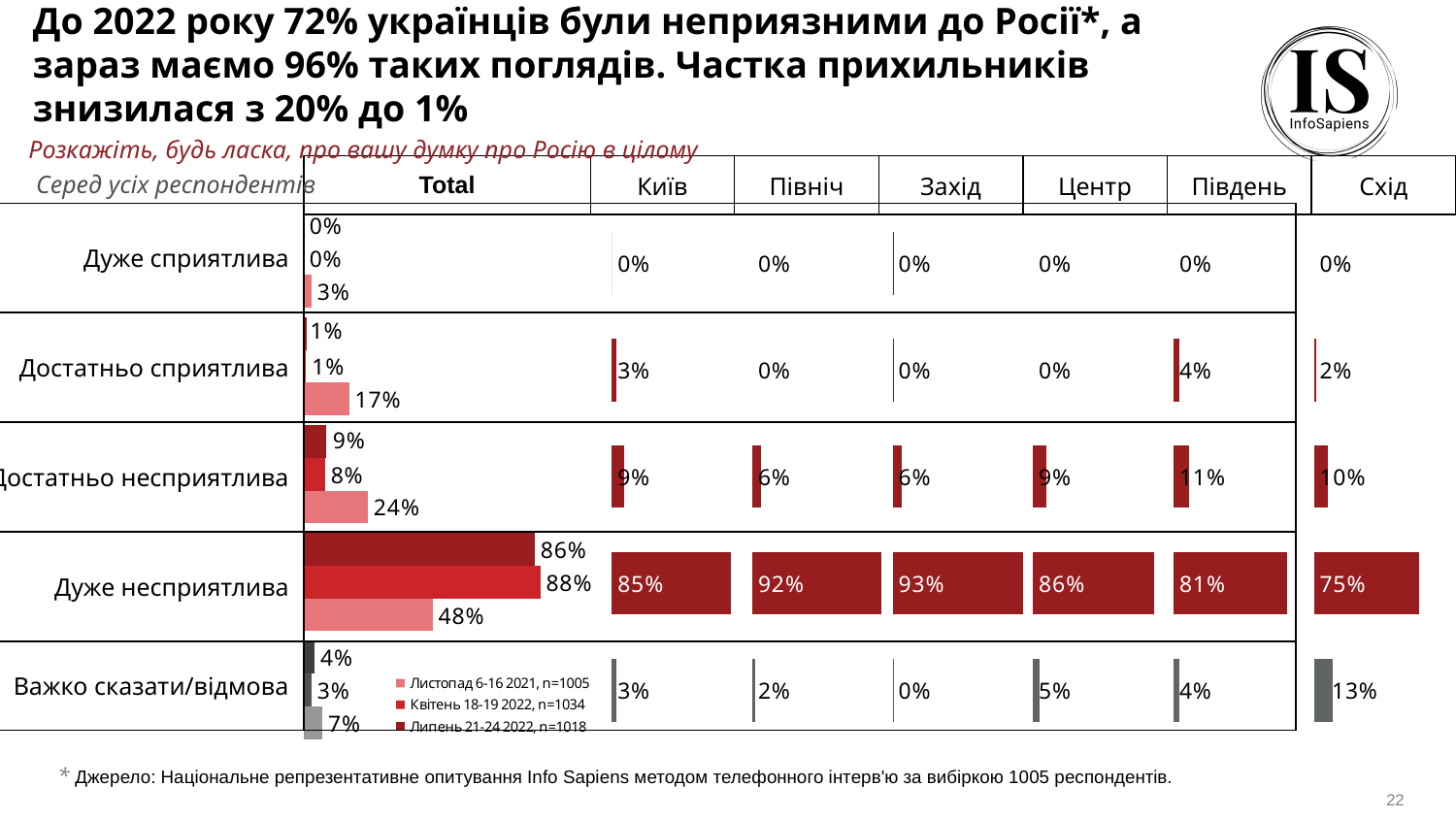
In the Total chart, which category has the highest value for the Липень 21-24 2022 series? Дуже несприятлива What kind of chart is the Total chart? bar chart In the Схід chart, what is the value for Важко сказати/відмова? 13% Is the value for Дуже несприятлива larger in the Північ chart or the Південь chart? Північ In the Total chart, how many series does the legend list? 3 In the Total chart, what value does the Листопад 6-16 2021 series show for Достатньо сприятлива? 17% In the Total chart, what value does the Листопад 6-16 2021 series show for Дуже несприятлива? 48% In the Захід chart, what is the value for Дуже несприятлива? 93% Which regional chart shows the lowest value for Дуже несприятлива? Схід In the Total chart, what value does the Квітень 18-19 2022 series show for Дуже несприятлива? 88% Which regional chart shows the highest value for Дуже несприятлива? Захід In the Total chart, what is the difference between the Квітень 18-19 2022 and Листопад 6-16 2021 values for Дуже несприятлива? 40%